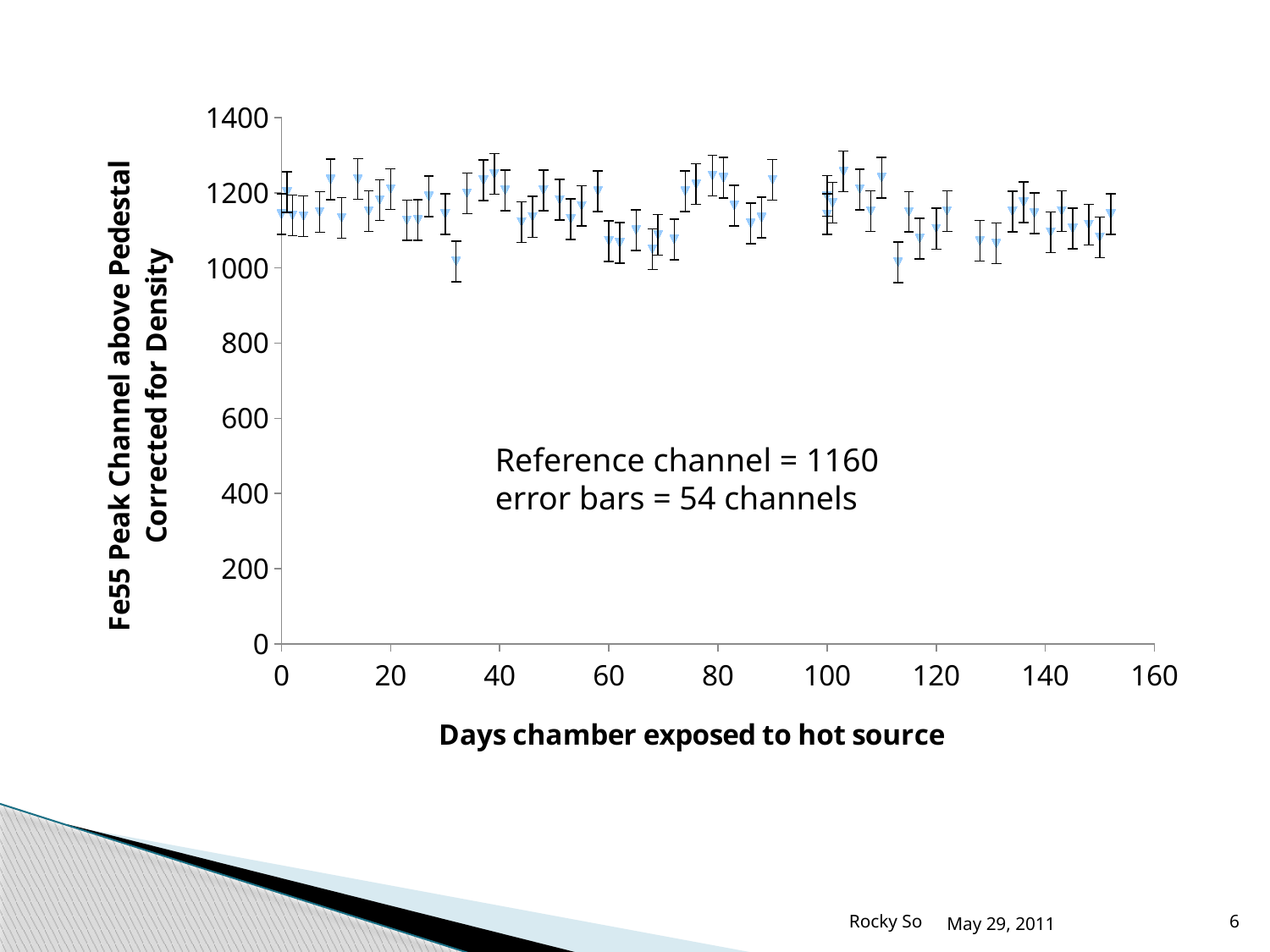
What kind of chart is shown on the slide? Scatter plot What is the title of the x axis? Days chamber exposed to hot source Is the value at day 60 greater or less than 1200? less Are any of the plotted points below 600? No Is the value at day 140 greater or less than 1400? less What is the maximum value shown on the y axis? 1400 According to the text on the chart, what is the reference channel value? 1160 Do the plotted values show a strong rise, a strong fall, or stay roughly flat as the days increase? Roughly flat